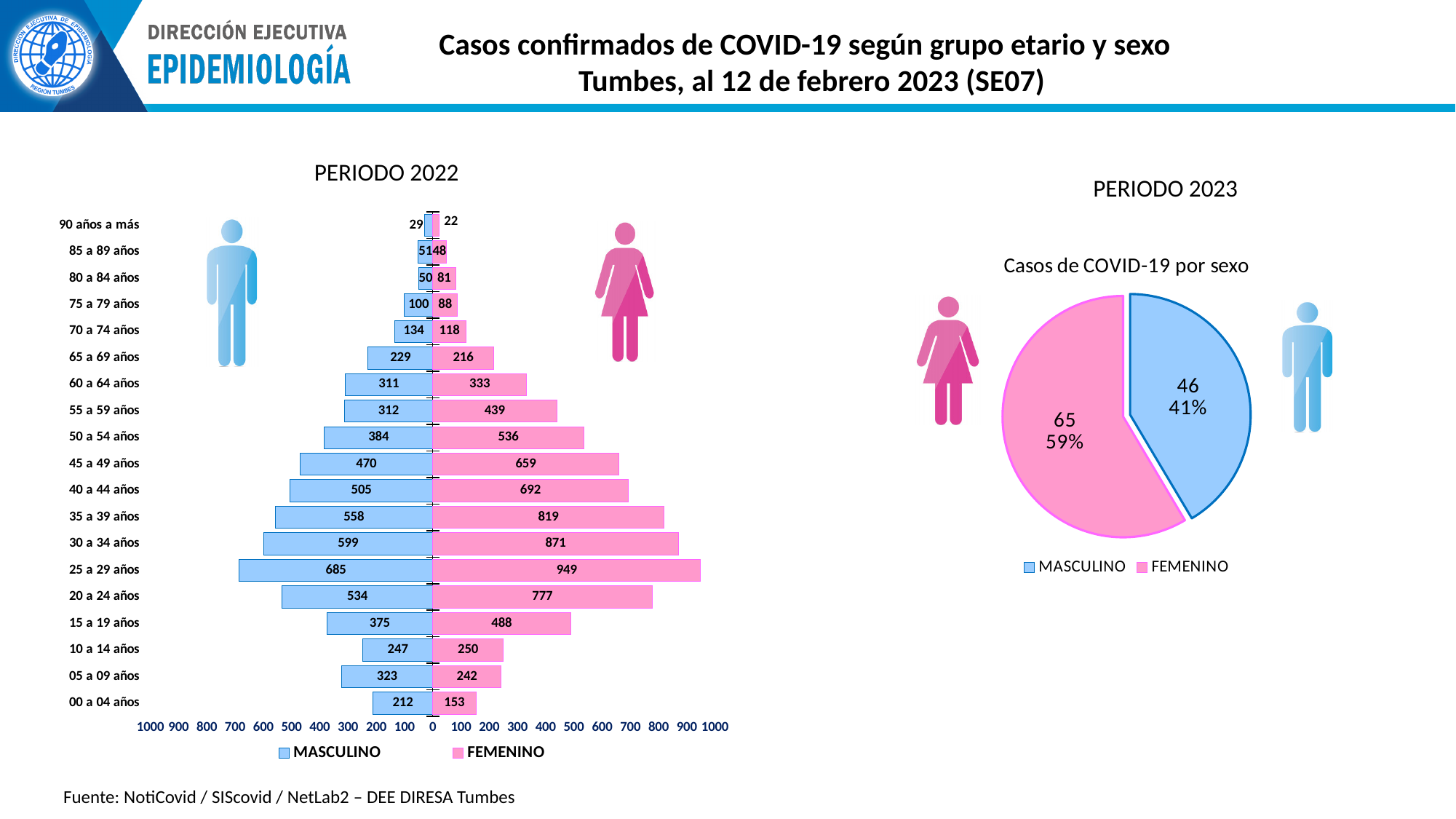
In the PERIODO 2022 chart, how many series does the legend list? 2 In the PERIODO 2022 chart, how many MASCULINO cases are in the 25 a 29 años group? 685 In the PERIODO 2022 chart, what is the difference between the FEMENINO and MASCULINO values for the 25 a 29 años group? 264 In the PERIODO 2022 chart, which age group has the highest FEMENINO value? 25 a 29 años In the PERIODO 2023 pie chart, how many MASCULINO cases are shown? 46 In the PERIODO 2023 pie chart, what is the total number of cases across both slices? 111 In the PERIODO 2023 pie chart, what share of cases is FEMENINO? 59% In the PERIODO 2022 chart, how many age groups are shown? 19 In the PERIODO 2022 chart, how many FEMENINO cases are in the 35 a 39 años group? 819 What kind of chart is the PERIODO 2022 chart? Bar chart In the PERIODO 2022 chart, which is larger for the 00 a 04 años group, MASCULINO or FEMENINO? MASCULINO In the PERIODO 2022 chart, which age group has the lowest MASCULINO value? 90 años a más